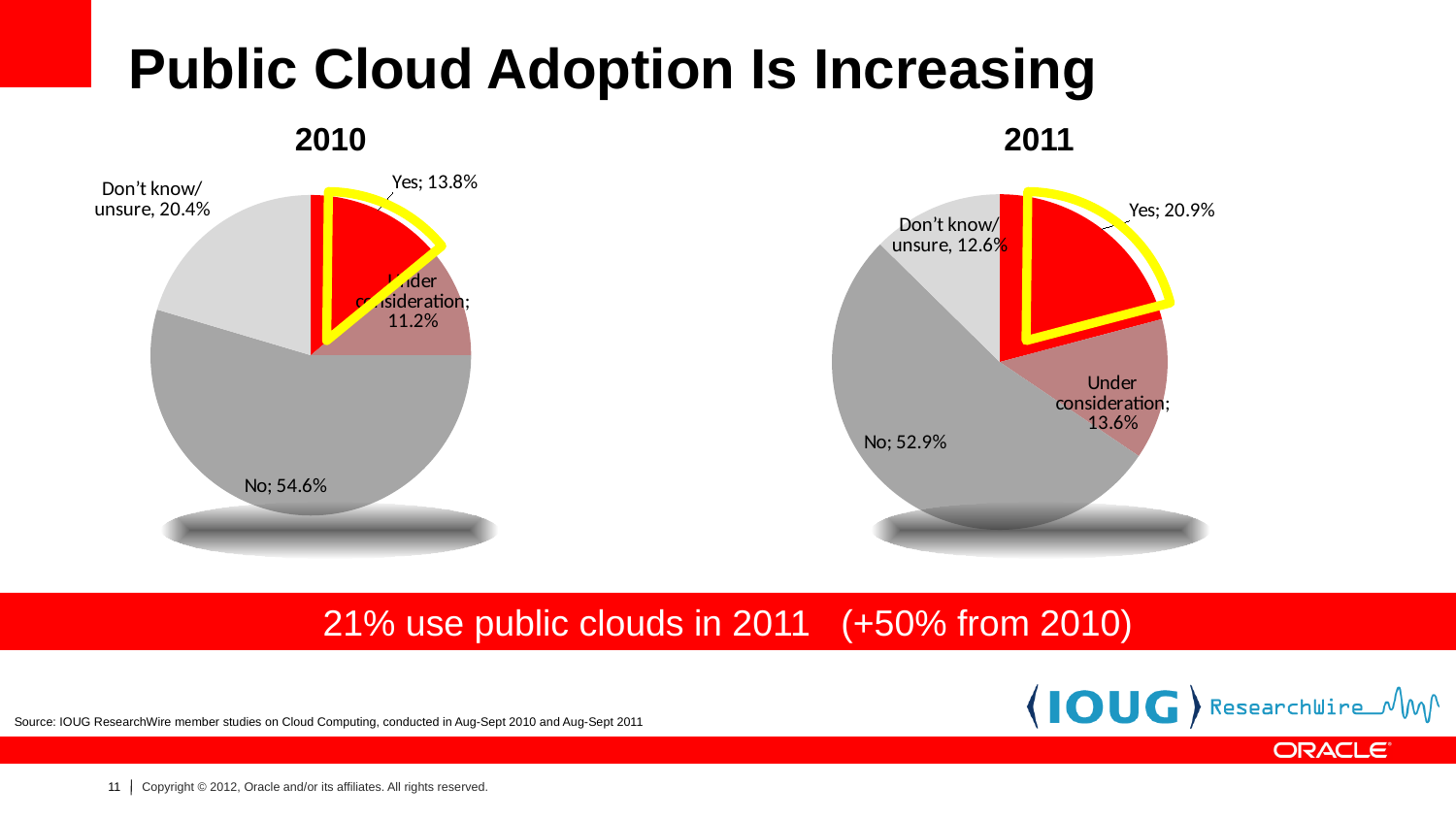
In the 2011 pie chart, what is the share for Under consideration? 13.6% In the 2011 pie chart, which category has the smallest slice? Don't know/unsure In the 2010 pie chart, which category has the smallest slice? Under consideration What type of chart is used to show the 2010 data? Pie chart In the 2011 pie chart, what is the share for No? 52.9% What is the difference between the Yes share in 2011 and the Yes share in 2010? 7.1% In the 2010 pie chart, what is the share for Don't know/unsure? 20.4% In the 2010 pie chart, which category has the largest slice? No Which is larger: the No share in 2010 or the No share in 2011? No share in 2010 How many slices does the 2011 pie chart have? 4 In the 2010 pie chart, what percentage answered Yes? 13.8% In the 2011 pie chart, what percentage answered Yes? 20.9%